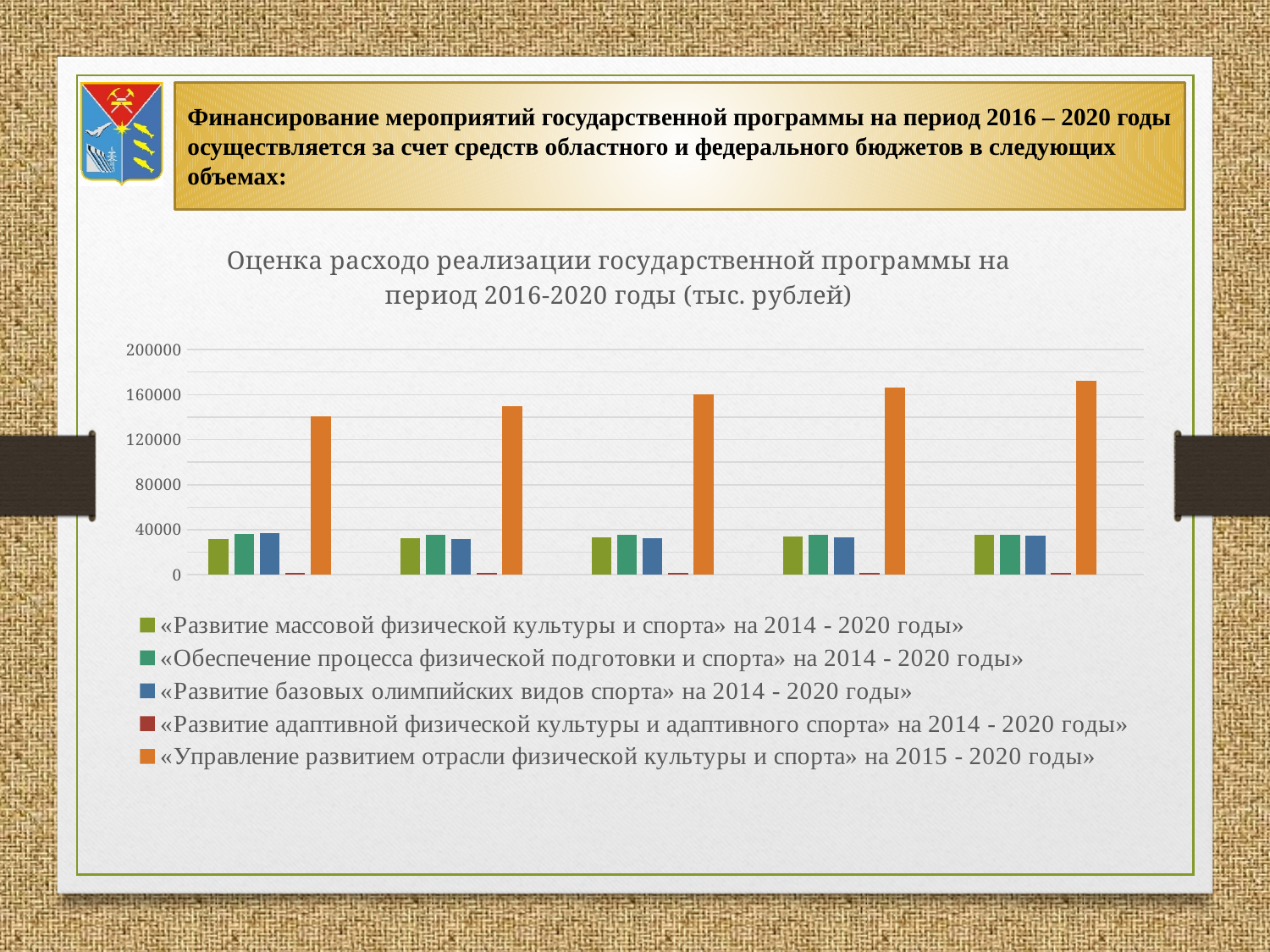
How many series does the legend list? 5 Is the value of the orange bar in the first group from the left greater or less than 120000? greater Do the values of the orange series rise or fall from left to right across the groups? rise What is the title of the chart? Оценка расходо реализации государственной программы на период 2016-2020 годы (тыс. рублей) In the third group from the left, which is larger: the orange bar or the blue bar? the orange bar What kind of chart is shown on the slide? bar chart Which series has the smallest bar in every group? «Развитие адаптивной физической культуры и адаптивного спорта» на 2014 - 2020 годы» Is the value of the olive-green bar in the first group from the left greater or less than 40000? less How many groups of bars are plotted along the x axis? 5 What colour represents the series «Развитие базовых олимпийских видов спорта» на 2014 - 2020 годы» in the legend? blue Is the value of the orange bar in the last group on the right greater or less than 160000? greater Which series has the tallest bar in every group? «Управление развитием отрасли физической культуры и спорта» на 2015 - 2020 годы»